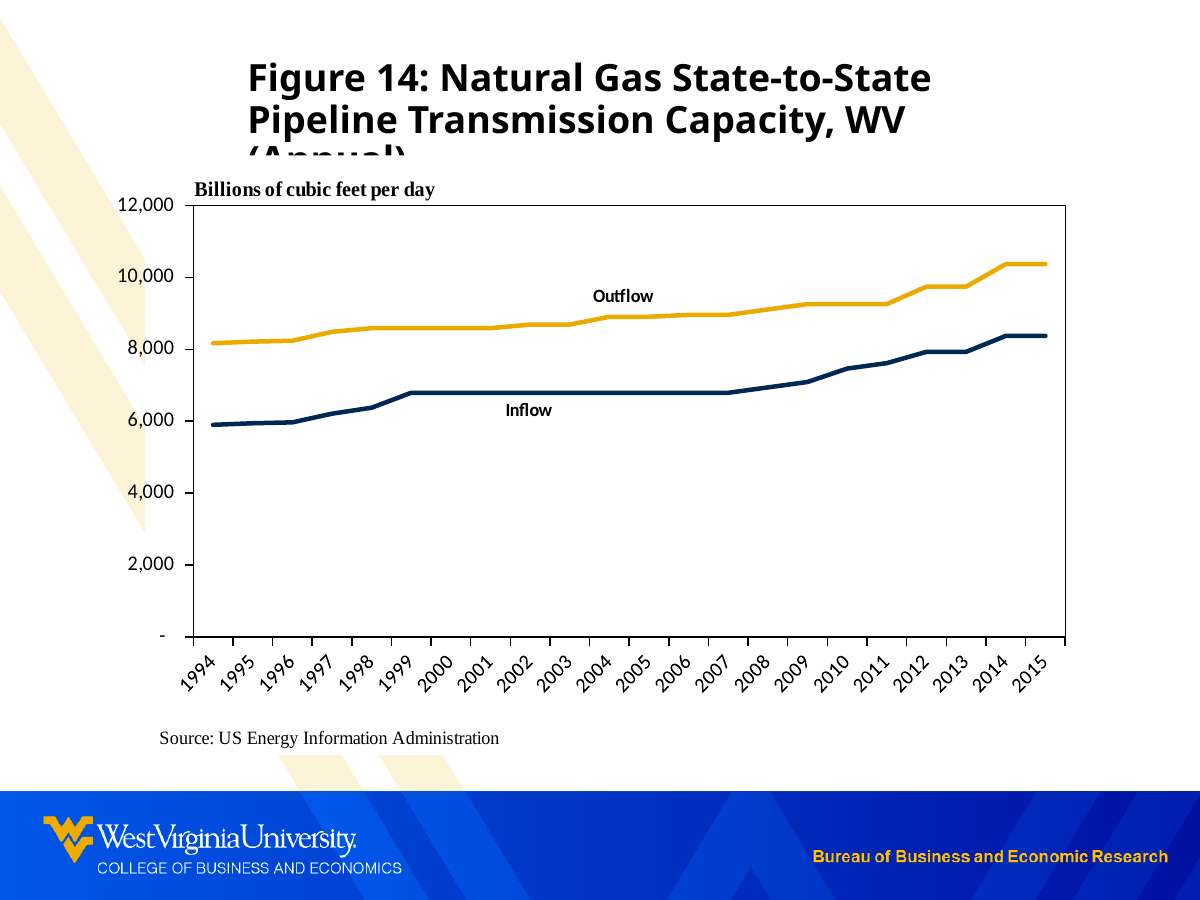
Is the Outflow value for 2005 greater or less than 10,000? less How many years are shown along the x axis? 22 What kind of chart is shown on the slide? Line chart Does the Outflow series generally rise or fall from 1994 to 2015? Rise How many series are plotted on the chart? 2 Is the Outflow value for 2015 greater or less than 10,000? greater What are the names of the two series plotted on the chart? Outflow and Inflow What is the first year shown on the x axis? 1994 Is the Inflow value for 2005 greater or less than 8,000? less In 2010, which series has the larger value, Outflow or Inflow? Outflow